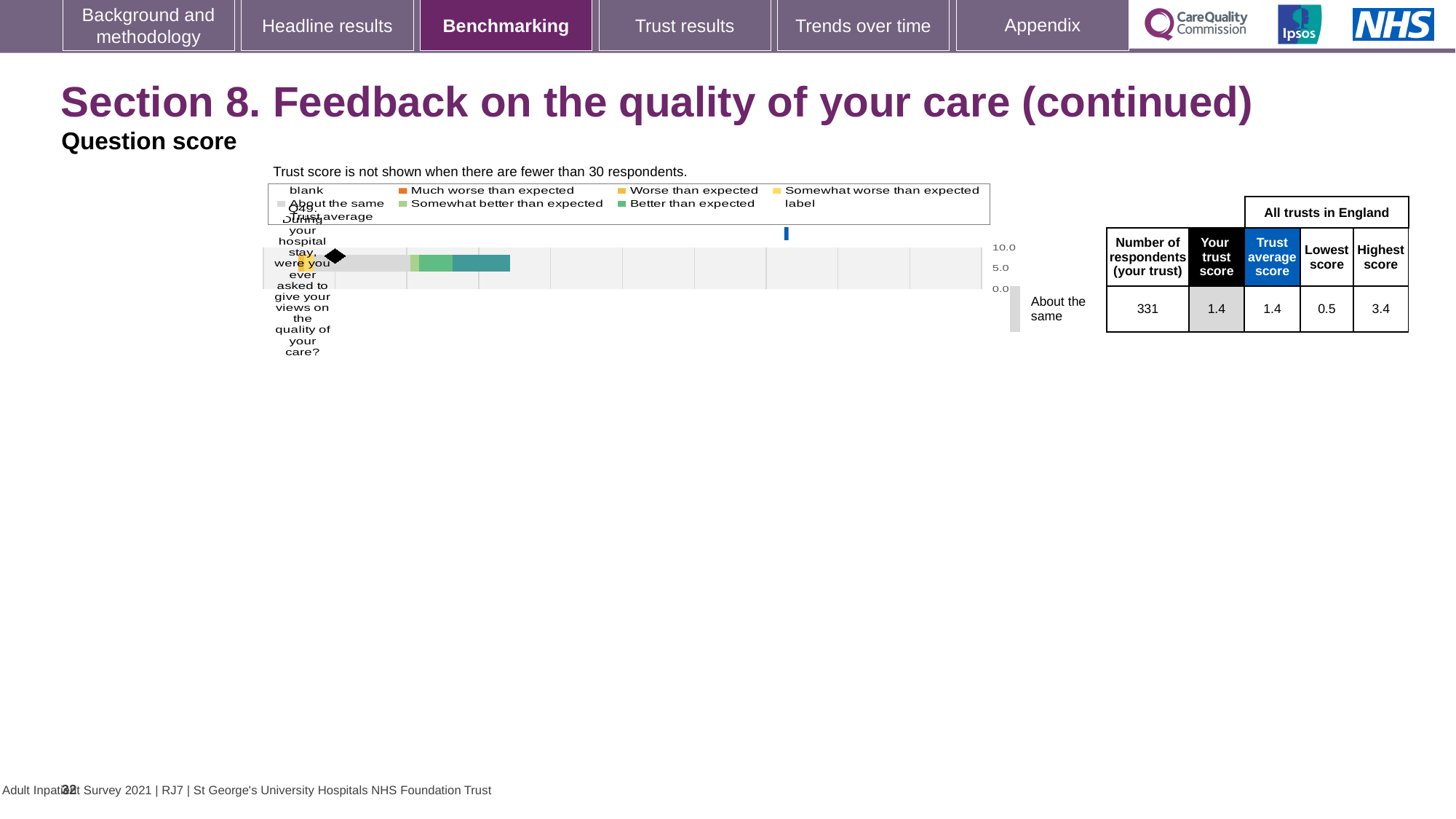
Which is larger for Q49: the highest score across all trusts or the trust's own score? Highest score What benchmarking category is the trust's Q49 result placed in? About the same How many respondents from the trust answered Q49? 331 How many survey questions are plotted in the chart? 1 Is the trust score for Q49 greater or less than 5.0? less What is the highest score among all trusts in England for Q49? 3.4 What is the trust score for Q49 shown on the slide? 1.4 What is the difference between the highest and lowest scores for Q49 across all trusts in England? 2.9 What is the lowest score among all trusts in England for Q49? 0.5 Which colour in the legend represents 'Much worse than expected'? orange What kind of chart is used to show the benchmarking result for Q49? bar chart What is the trust average score for Q49? 1.4